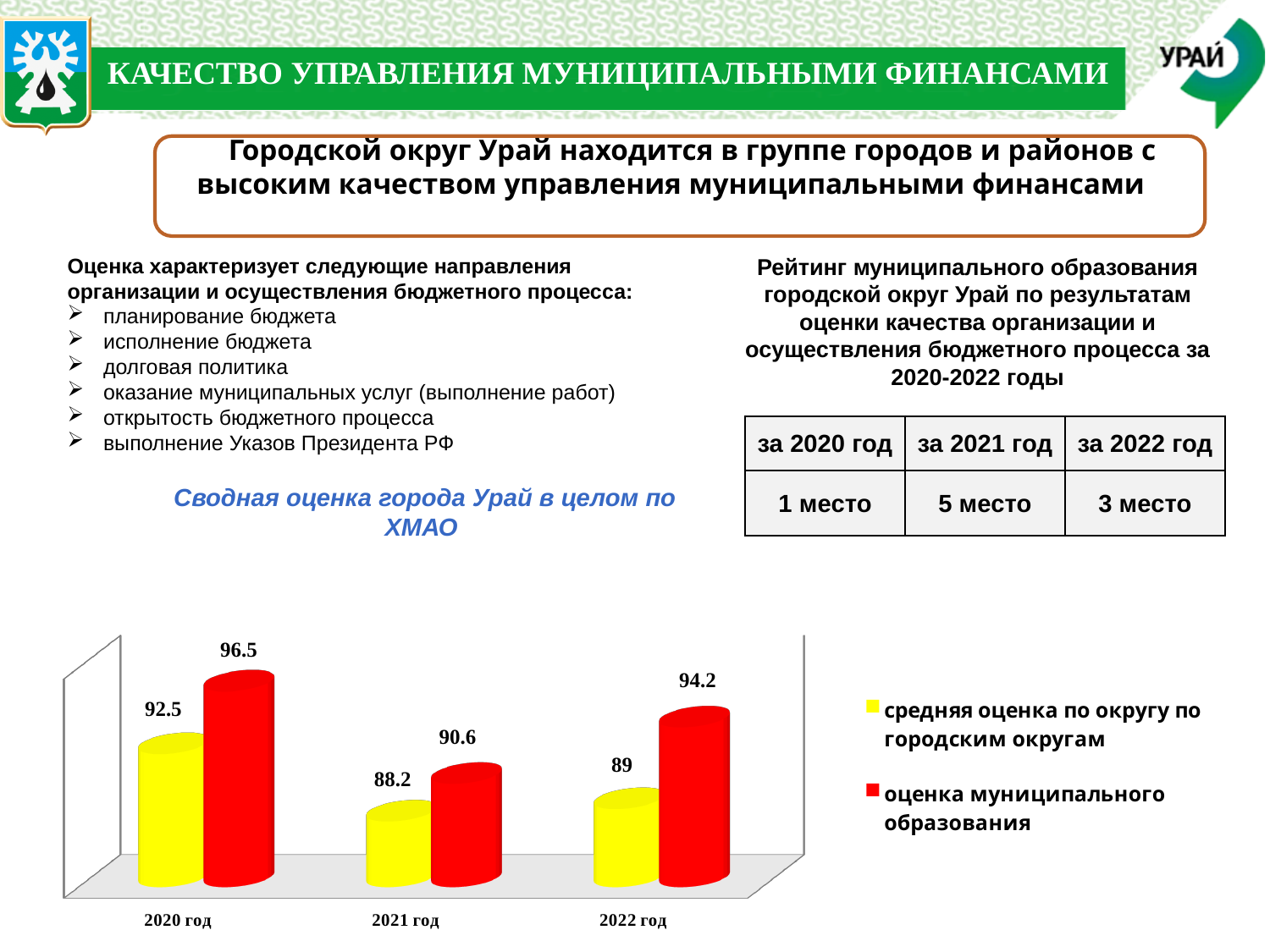
What kind of chart is shown on the slide? Bar chart How many years are shown on the x axis of the chart? 3 Which is larger in 2021 год: 'оценка муниципального образования' or 'средняя оценка по округу по городским округам'? оценка муниципального образования How many series does the chart legend list? 2 What is the value of 'оценка муниципального образования' for 2022 год? 94.2 What is the value of 'оценка муниципального образования' for 2020 год? 96.5 In which year is 'средняя оценка по округу по городским округам' the lowest? 2021 год What is the value of 'средняя оценка по округу по городским округам' for 2021 год? 88.2 Which colour represents 'оценка муниципального образования' in the chart? Red What is the difference between 'оценка муниципального образования' and 'средняя оценка по округу по городским округам' in 2022 год? 5.2 In which year is 'оценка муниципального образования' the highest? 2020 год What is the value of 'средняя оценка по округу по городским округам' for 2022 год? 89